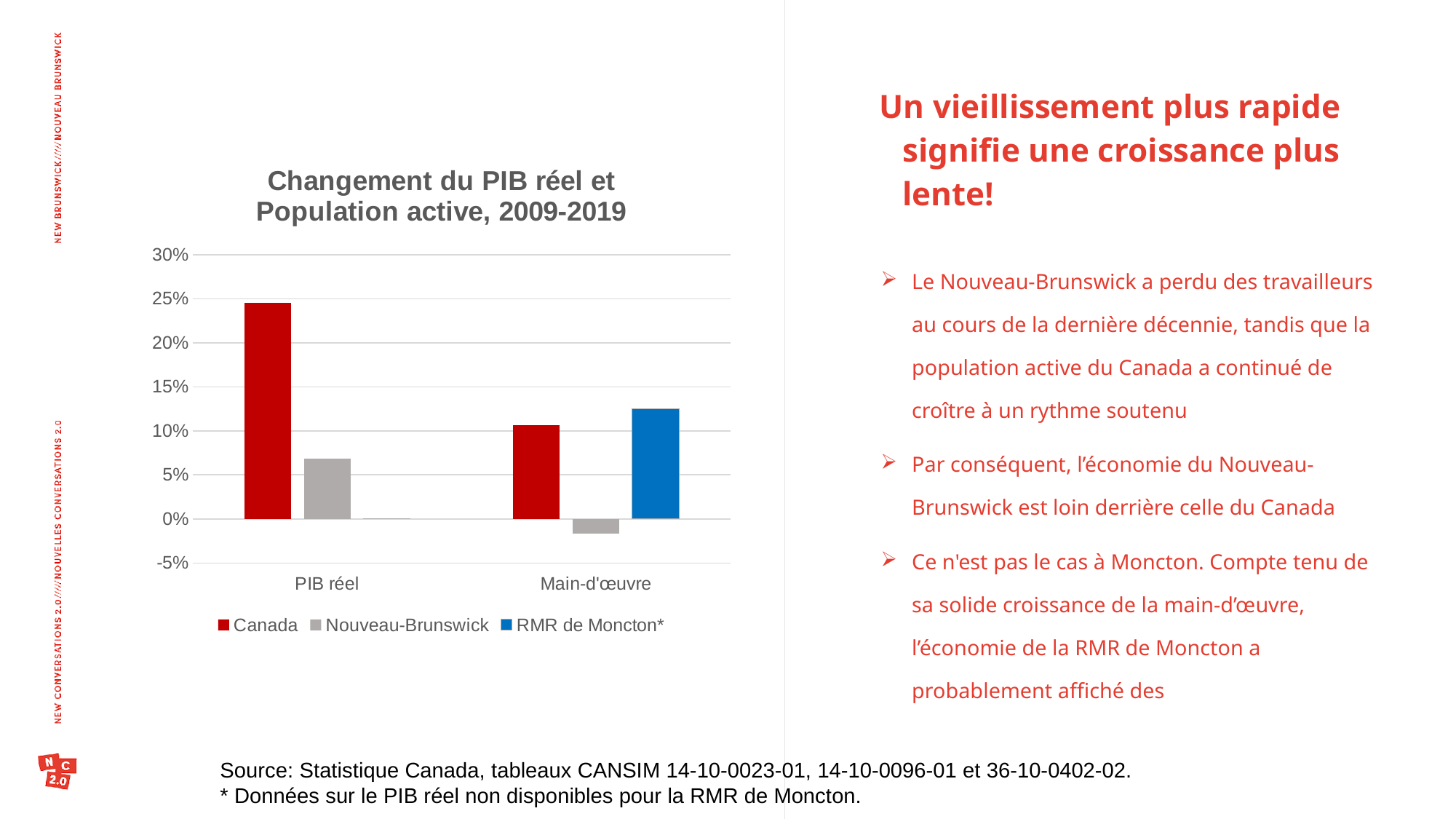
Is the value for Canada in PIB réel greater or less than 20%? greater How many categories are shown on the x axis? 2 Is the value for Nouveau-Brunswick in Main-d'œuvre greater or less than 0%? less Which series has the lowest value for Main-d'œuvre? Nouveau-Brunswick For Main-d'œuvre, which is larger: Canada or RMR de Moncton*? RMR de Moncton* What kind of chart is shown on the slide? bar chart How many series does the legend list? 3 What is the title of the chart? Changement du PIB réel et Population active, 2009-2019 Which series has the highest value for PIB réel? Canada Is the value for RMR de Moncton* in Main-d'œuvre greater or less than 10%? greater What colour represents RMR de Moncton* in the chart? blue